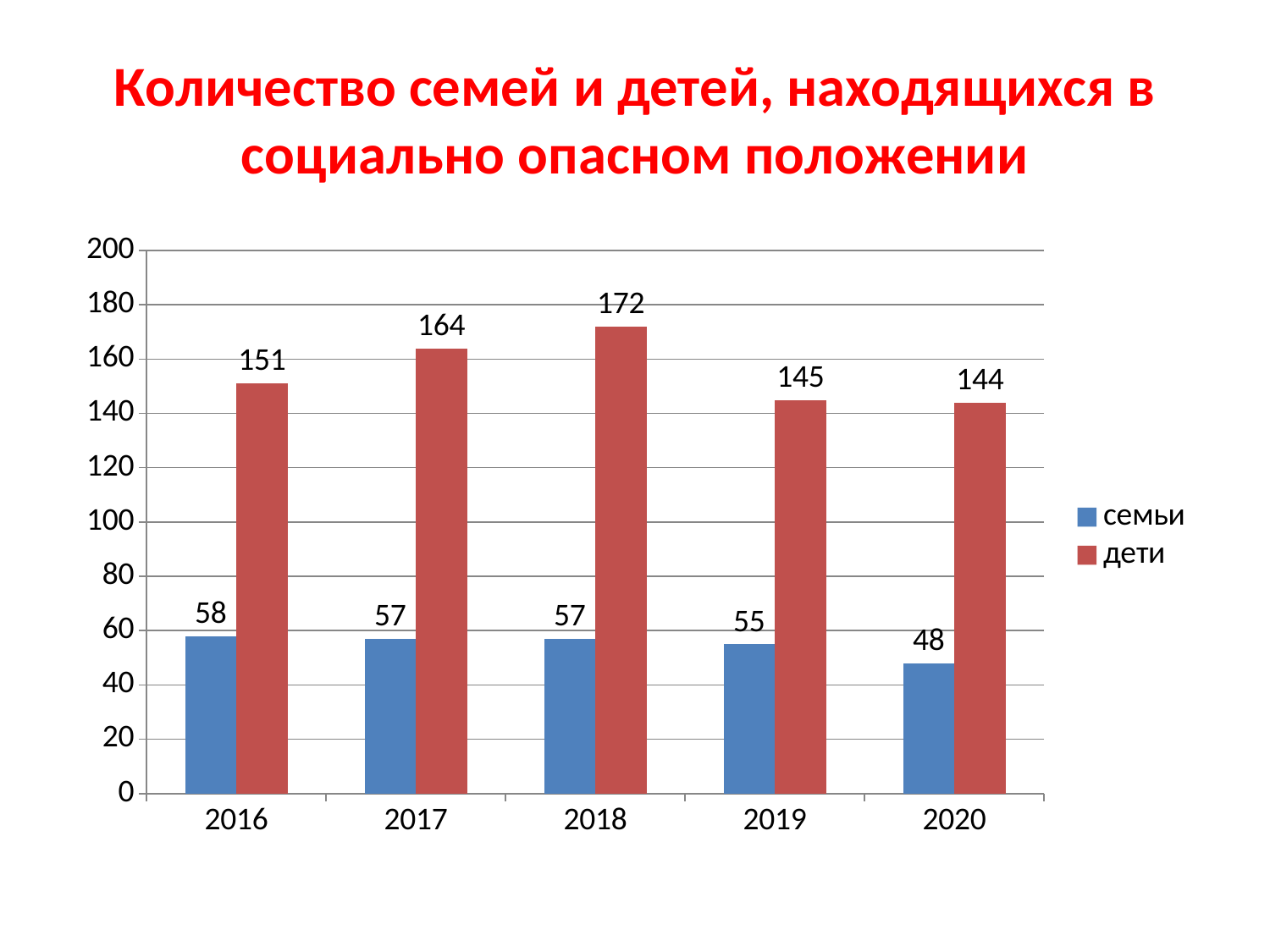
What is the value for дети in 2018? 172 What is the value for семьи in 2020? 48 What is the value for дети in 2016? 151 In which year is the value for дети highest? 2018 Which series is shown in red? дети How many series does the legend list? 2 What kind of chart is shown on the slide? bar chart What is the difference between the семьи values for 2016 and 2020? 10 How many years are shown on the x axis? 5 What is the difference between the дети values for 2018 and 2020? 28 In which year is the value for семьи lowest? 2020 Which is larger, the дети value for 2017 or for 2019? 2017